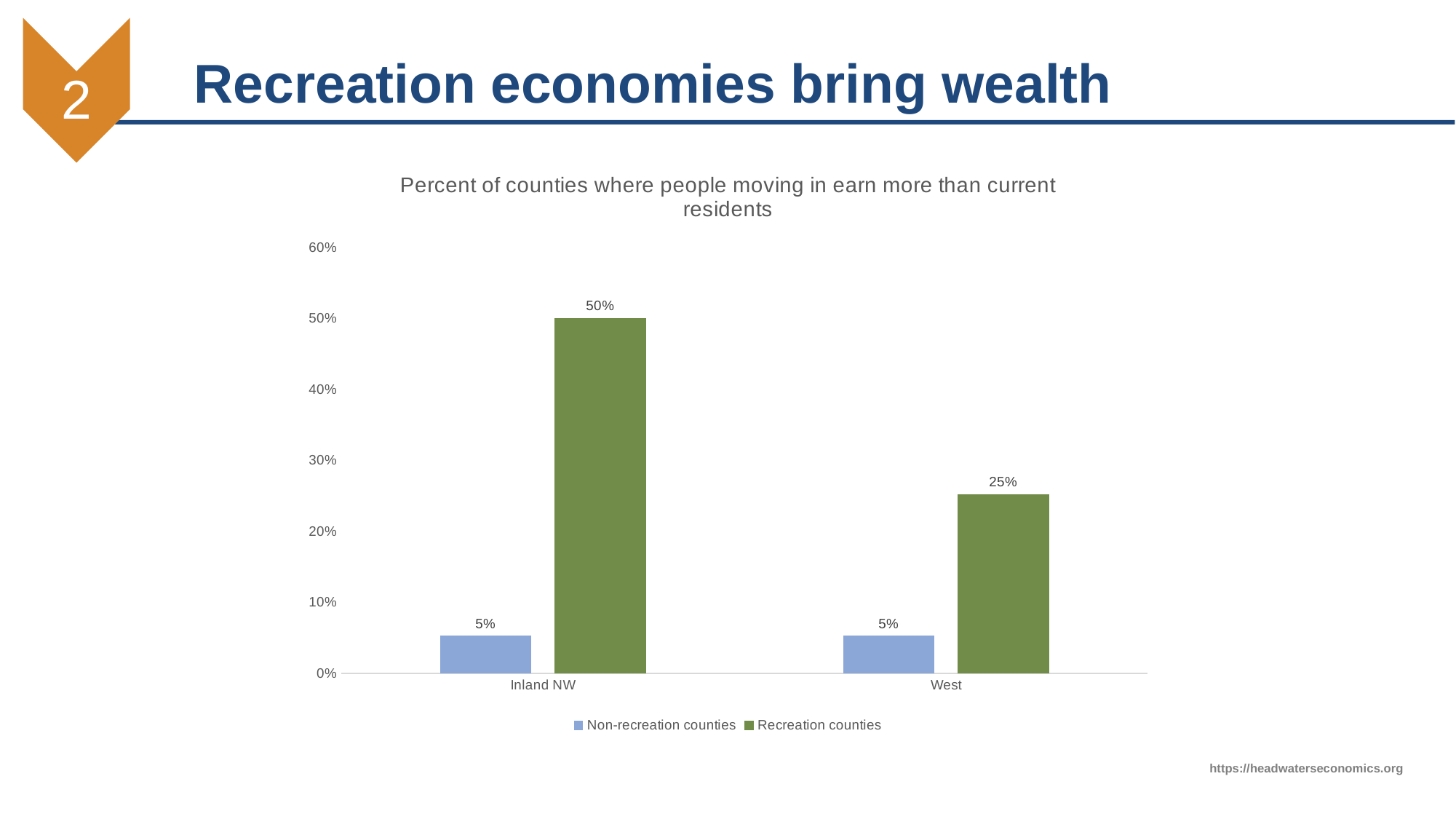
What kind of chart is shown on the slide? Bar chart What is the value for Recreation counties in Inland NW? 50% Which is larger in West: Recreation counties or Non-recreation counties? Recreation counties What is the value for Non-recreation counties in West? 5% What is the difference between the Recreation counties values for Inland NW and West? 25% Is the value for Recreation counties in West greater or less than 20%? greater What is the title of the chart? Percent of counties where people moving in earn more than current residents How many categories are shown on the x axis? 2 How many series does the legend list? 2 What is the value for Recreation counties in West? 25% Which category has the highest value for Recreation counties? Inland NW What is the difference between Recreation counties and Non-recreation counties in Inland NW? 45%